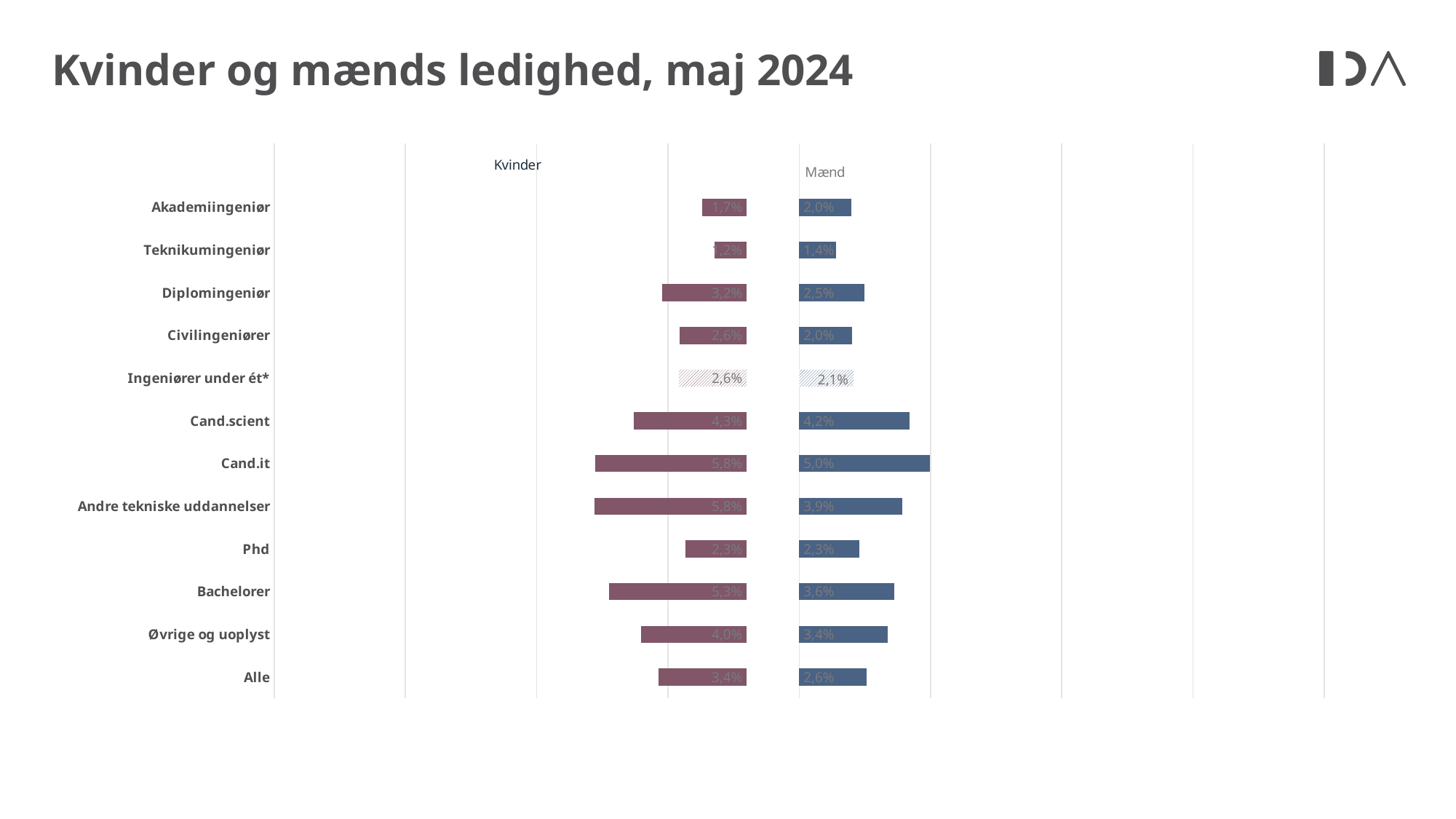
What is the value for Mænd in the Alle category? 2,6% Which category has the lowest unemployment rate for Mænd? Teknikumingeniør What is the difference between the Kvinder and Mænd values for Andre tekniske uddannelser? 1,9 percentage points What kind of chart is shown on the slide? Bar chart For Diplomingeniør, which is higher: the Kvinder value or the Mænd value? Kvinder What is the unemployment rate for Mænd in the Bachelorer category? 3,6% Which category has the lowest unemployment rate for Kvinder? Teknikumingeniør Which category has the highest unemployment rate for Mænd? Cand.it How many education categories are shown in the chart? 12 What is the unemployment rate for Kvinder in the Cand.it category? 5,8% What is the value for Kvinder in the Ingeniører under ét* category? 2,6% How many series does the chart show? 2